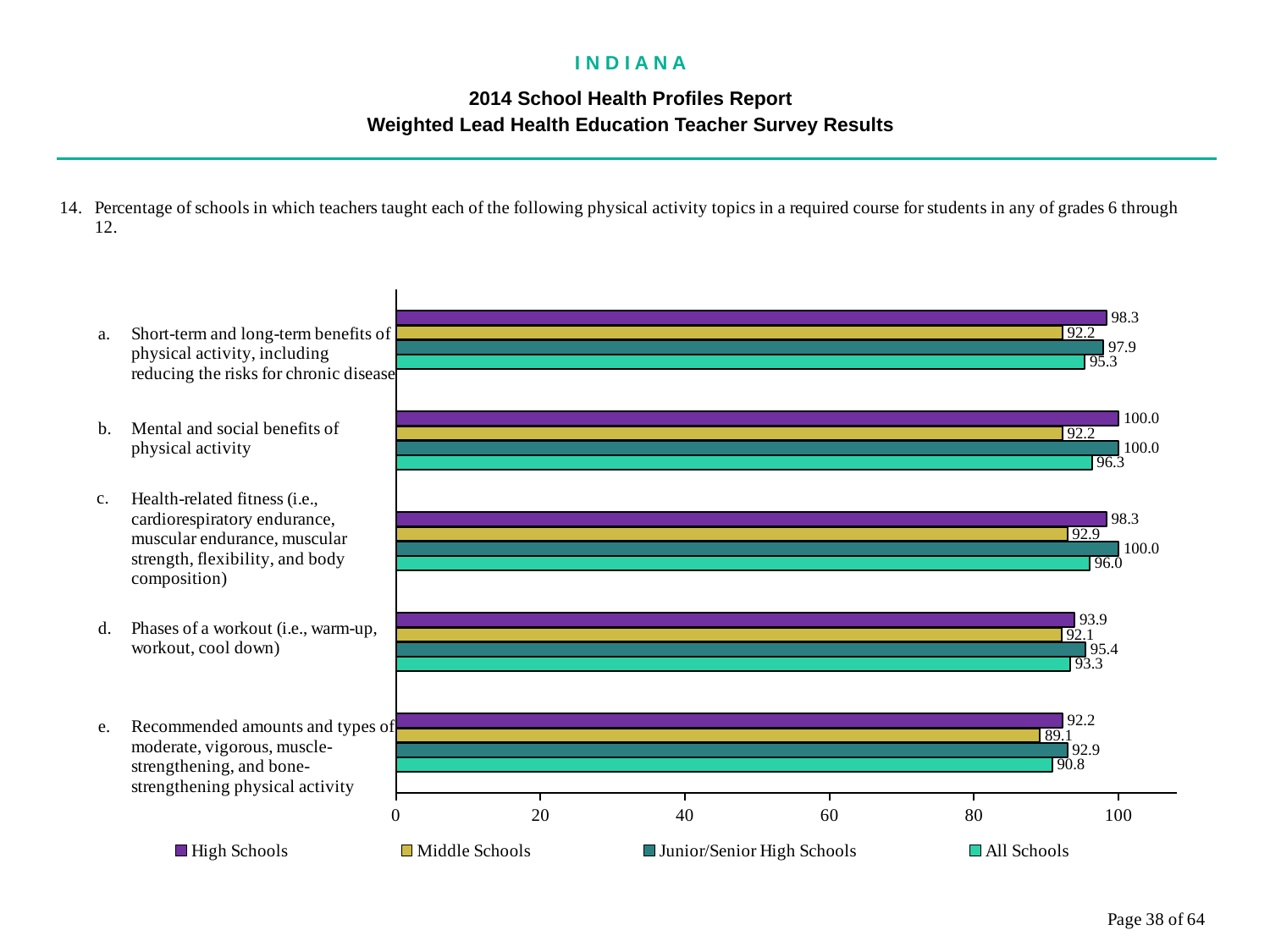
What is the value for All Schools for topic e (recommended amounts and types of physical activity)? 90.8 What is the value for High Schools for topic a (short-term and long-term benefits of physical activity)? 98.3 For topic c (health-related fitness), which is larger: the Junior/Senior High Schools value or the High Schools value? Junior/Senior High Schools How many series does the legend list? 4 Is the Middle Schools value for topic e (recommended amounts and types of physical activity) greater or less than 80? greater How many physical activity topics are shown on the chart? 5 Which topic has the lowest Middle Schools value? e. Recommended amounts and types of moderate, vigorous, muscle-strengthening, and bone-strengthening physical activity What kind of chart is shown on the slide? bar chart What is the value for Middle Schools for topic d (phases of a workout)? 92.1 What is the difference between the High Schools and Middle Schools values for topic b (mental and social benefits of physical activity)? 7.8 Which series is shown in the legend immediately after High Schools? Middle Schools Which topic has the highest All Schools value? b. Mental and social benefits of physical activity